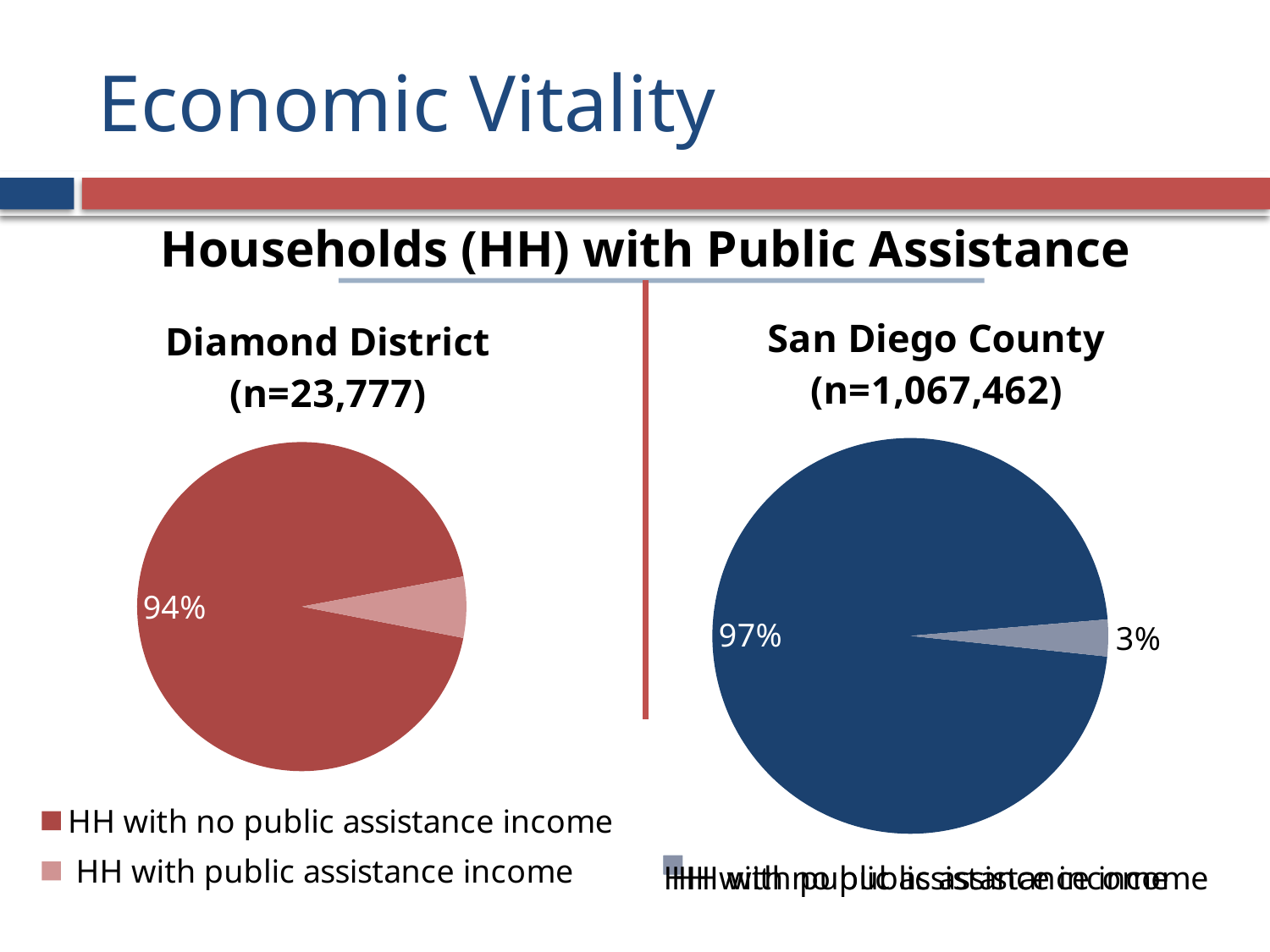
In the Diamond District chart, what share of households have no public assistance income? 94% What is the title shown above the two pie charts? Households (HH) with Public Assistance What sample size (n) is given for the Diamond District chart? 23,777 Which is larger: the largest slice in the Diamond District chart or the largest slice in the San Diego County chart? San Diego County In the San Diego County chart, what percentage is shown for the smallest slice? 3% In the San Diego County chart, which slice is smaller, the 97% slice or the 3% slice? the 3% slice What kind of chart is the Diamond District chart? pie chart How many slices does the Diamond District pie chart have? 2 What is the difference between the largest slice in the San Diego County chart (97%) and the largest slice in the Diamond District chart (94%)? 3 percentage points How many entries does the legend for the Diamond District chart list? 2 In the San Diego County chart, what percentage is shown for the largest slice? 97% In the Diamond District chart, which category has the largest slice? HH with no public assistance income